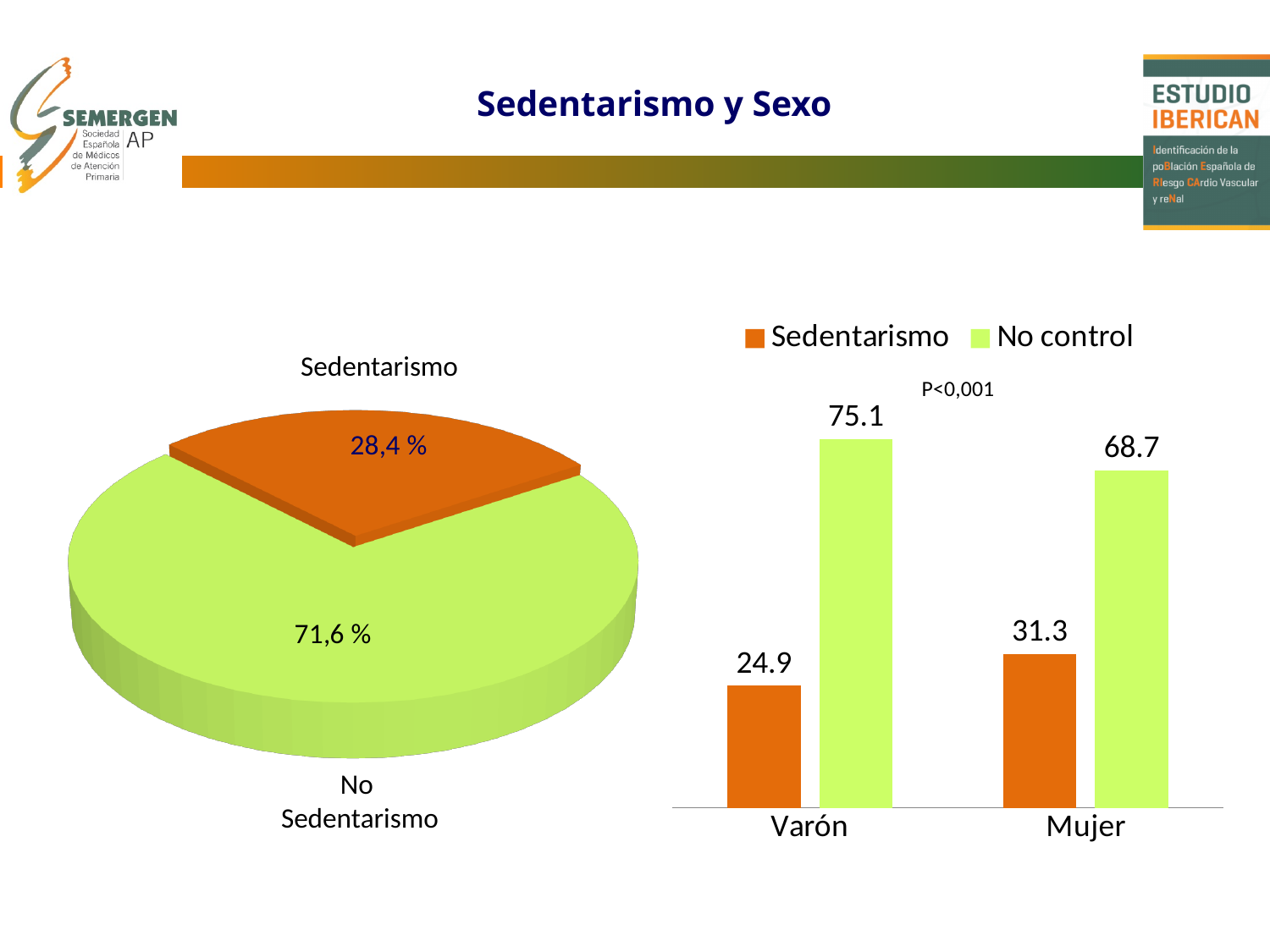
What kind of chart is the chart on the right? Bar chart In the bar chart on the right, which category has the higher No control value, Varón or Mujer? Varón In the bar chart on the right, what is the Sedentarismo value for Varón? 24.9 In the bar chart on the right, what is the No control value for Mujer? 68.7 In the bar chart on the right, what p-value is shown above the bars? P<0,001 In the pie chart on the left, which slice is larger, Sedentarismo or No Sedentarismo? No Sedentarismo What kind of chart is the chart on the left? Pie chart In the bar chart on the right, what is the difference between the Sedentarismo values for Mujer and Varón? 6.4 In the pie chart on the left, what share is labelled for Sedentarismo? 28,4 % In the bar chart on the right, how many series does the legend list? 2 In the pie chart on the left, how many slices are there? 2 In the pie chart on the left, what share is labelled for No Sedentarismo? 71,6 %